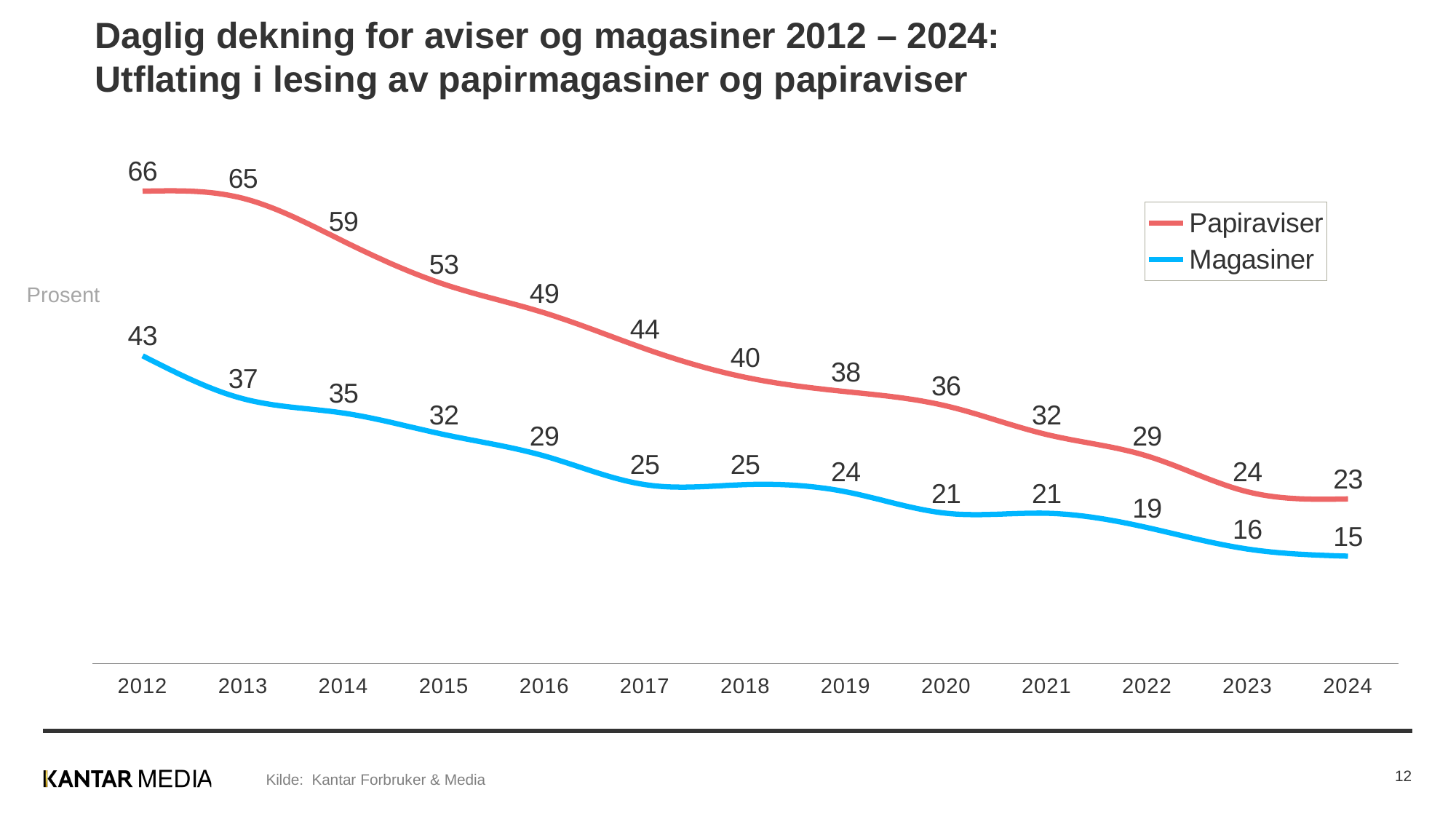
By how much did the Papiraviser value fall from 2012 to 2024? 43 How many series does the legend list? 2 Which is larger in 2020, Papiraviser or Magasiner? Papiraviser In which year is the Papiraviser value lowest? 2024 What is the value for Papiraviser in 2012? 66 What kind of chart is shown? Line chart How many years are shown on the x axis? 13 Do the Papiraviser values rise or fall from 2012 to 2024? Fall What is the difference between Papiraviser and Magasiner in 2016? 20 What is the value for Magasiner in 2018? 25 In which year is the Magasiner value highest? 2012 What is the value for Magasiner in 2024? 15